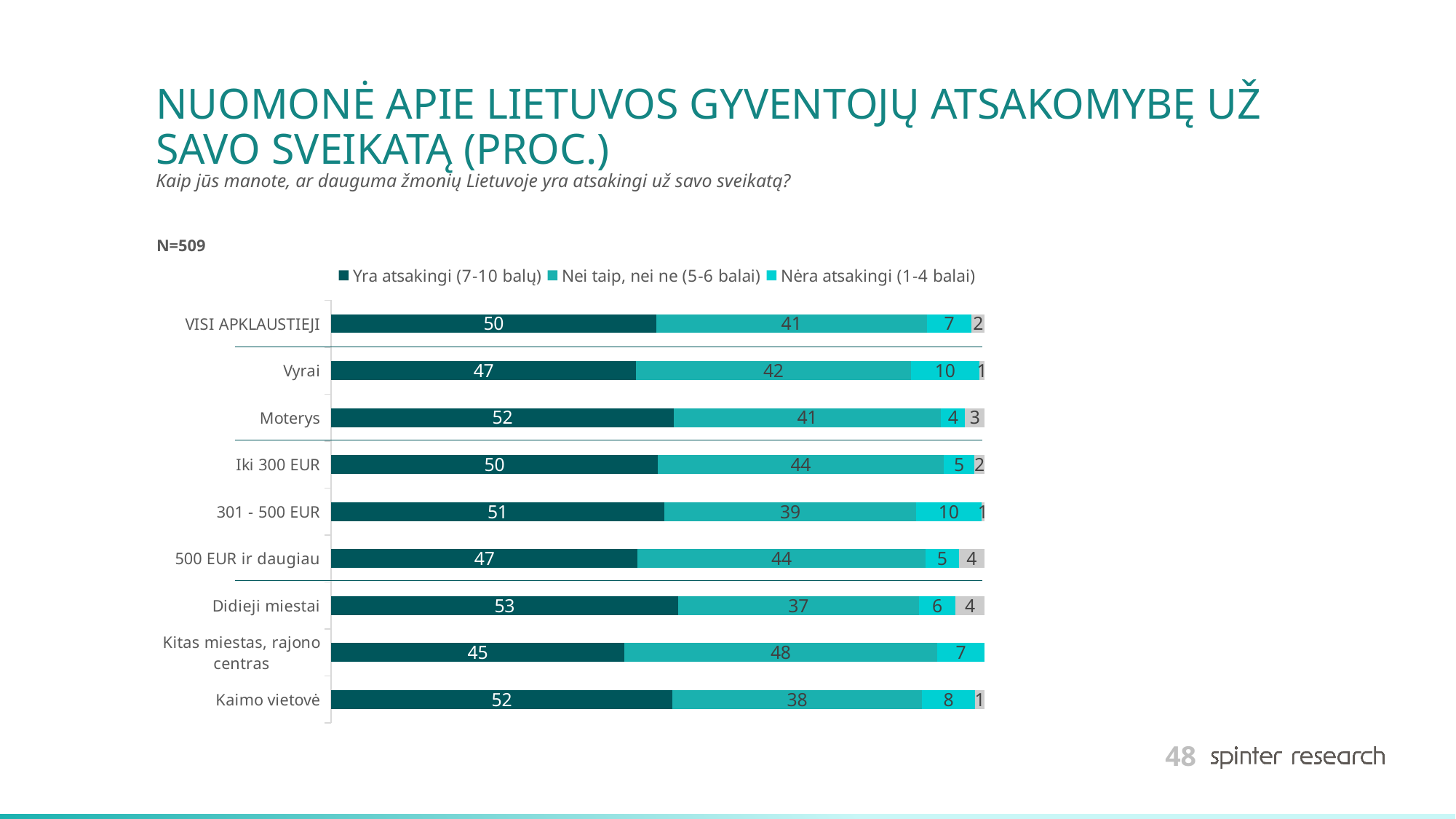
What is the value of 'Nėra atsakingi (1-4 balai)' for Vyrai? 10 What is the value of 'Yra atsakingi (7-10 balų)' for VISI APKLAUSTIEJI? 50 Which category has the lowest value for 'Yra atsakingi (7-10 balų)'? Kitas miestas, rajono centras What is the difference between the 'Yra atsakingi (7-10 balų)' values for Moterys and Vyrai? 5 Which category has the highest value for 'Nei taip, nei ne (5-6 balai)'? Kitas miestas, rajono centras What is the sample size (N) stated on the slide? N=509 Which is larger: the 'Nei taip, nei ne (5-6 balai)' value for Iki 300 EUR or for 301 - 500 EUR? Iki 300 EUR How many series does the legend list? 3 Which category has the highest value for 'Yra atsakingi (7-10 balų)'? Didieji miestai What kind of chart is shown on the slide? Stacked bar chart What is the value of 'Nei taip, nei ne (5-6 balai)' for Kitas miestas, rajono centras? 48 How many categories are shown on the chart? 9